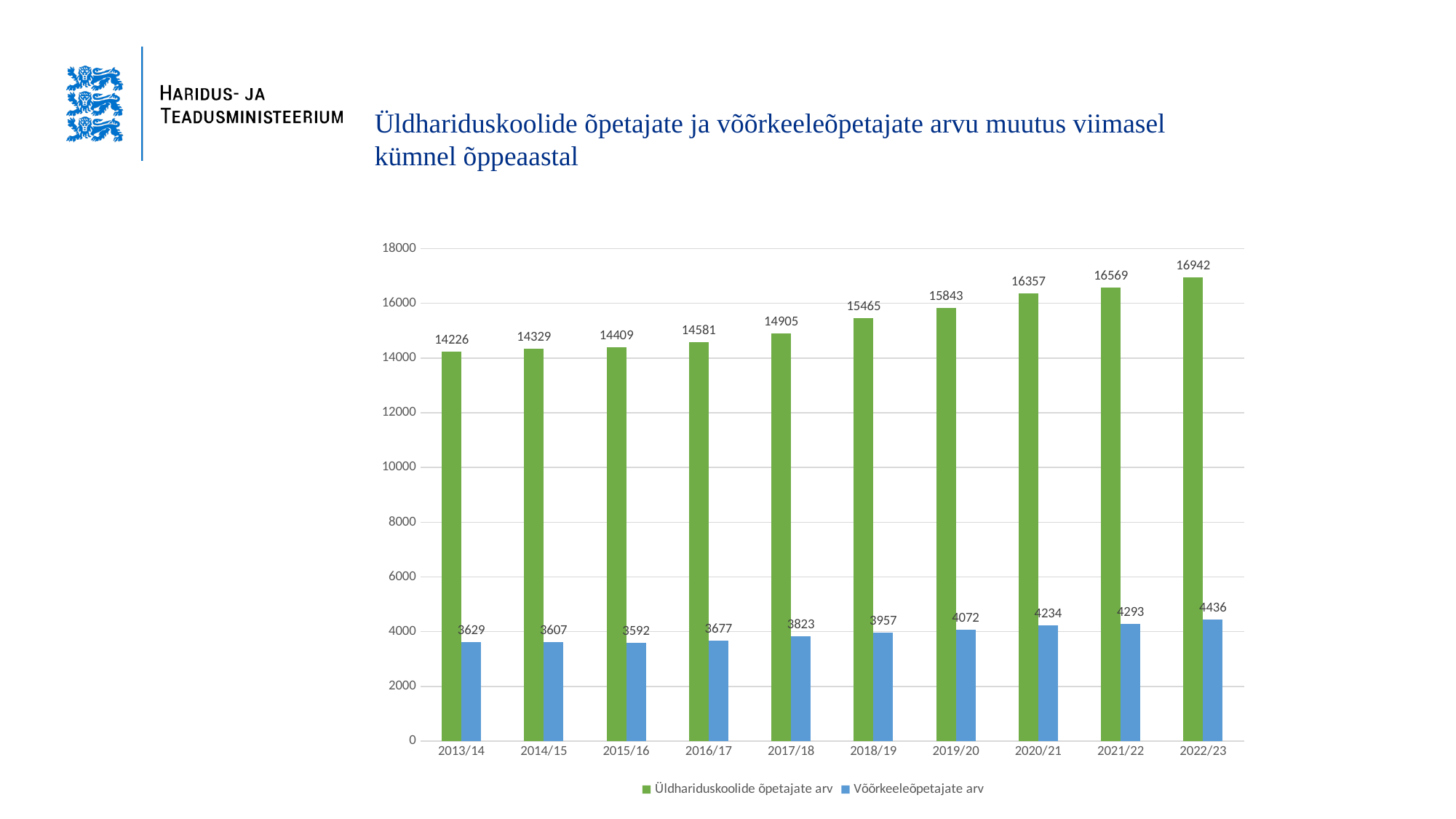
What is the value for Võõrkeeleõpetajate arv in 2017/18? 3823 How many school years are shown on the x axis? 10 Does Üldhariduskoolide õpetajate arv rise or fall from 2013/14 to 2022/23? Rise In which school year is Üldhariduskoolide õpetajate arv highest? 2022/23 By how much did Võõrkeeleõpetajate arv increase from 2013/14 to 2022/23? 807 Which is larger: Võõrkeeleõpetajate arv in 2014/15 or in 2016/17? 2016/17 What kind of chart is shown on the slide? Bar chart In which school year is Võõrkeeleõpetajate arv lowest? 2015/16 What is the value for Üldhariduskoolide õpetajate arv in 2022/23? 16942 How many series does the legend list? 2 What is the value for Üldhariduskoolide õpetajate arv in 2013/14? 14226 What is the difference between Üldhariduskoolide õpetajate arv in 2022/23 and in 2013/14? 2716